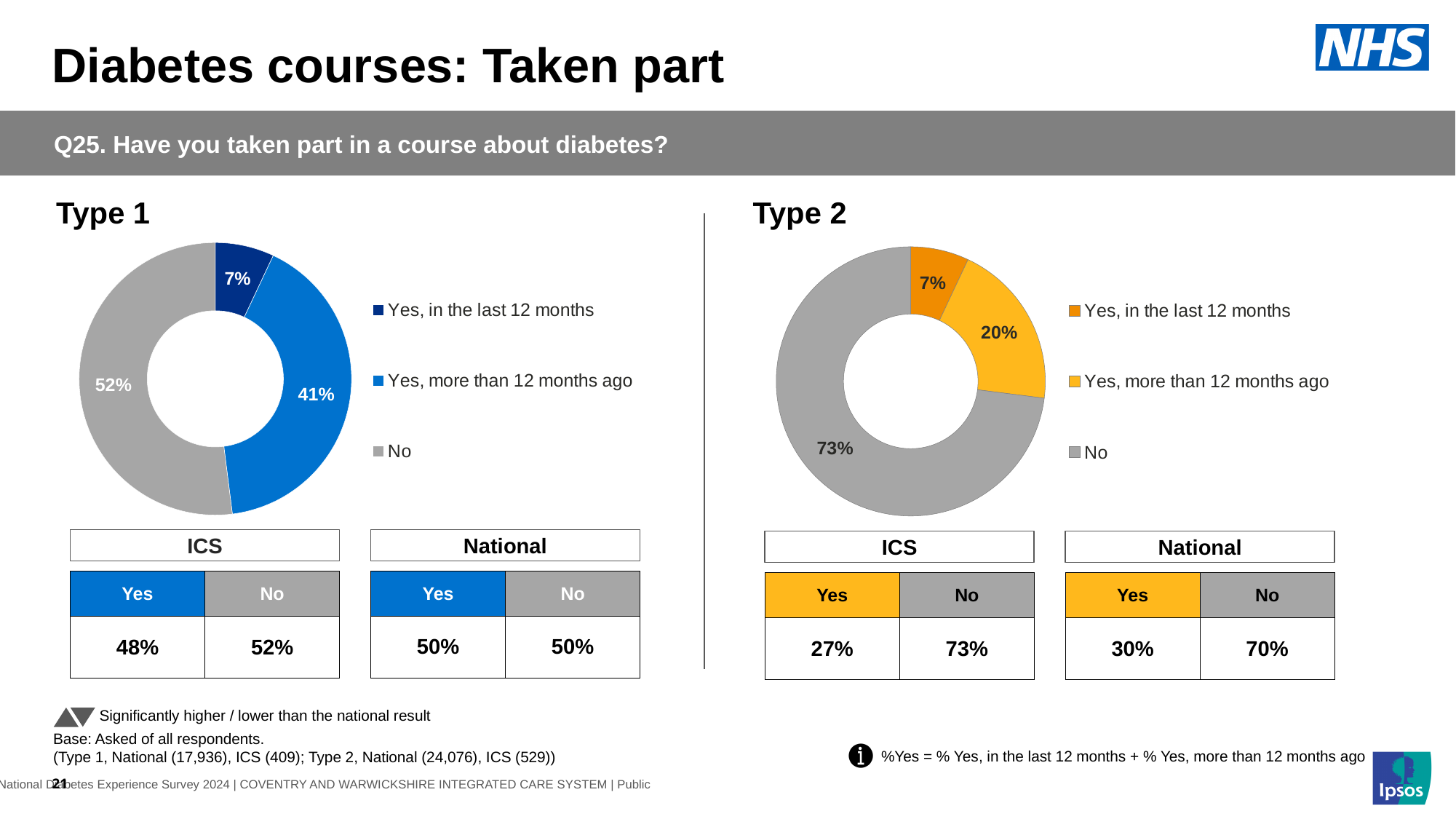
In the Type 1 chart, what percentage of respondents answered 'Yes, more than 12 months ago'? 41% In the Type 2 chart, what colour is the 'Yes, in the last 12 months' segment? Orange How many categories does the legend of the Type 2 chart list? 3 Which is larger: the 'Yes, more than 12 months ago' share in the Type 1 chart or in the Type 2 chart? Type 1 In the Type 1 chart, what is the difference between the 'No' share and the 'Yes, more than 12 months ago' share? 11% In the Type 2 chart, what percentage of respondents answered 'Yes, more than 12 months ago'? 20% In the Type 1 chart, what is the combined share of the two 'Yes' responses? 48% In the Type 1 chart, which response has the largest share? No In the Type 1 chart, what percentage of respondents answered 'Yes, in the last 12 months'? 7% In the Type 2 chart, what percentage of respondents answered 'No'? 73% In the Type 2 chart, which response has the smallest share? Yes, in the last 12 months What kind of chart is used for Type 1? Doughnut chart